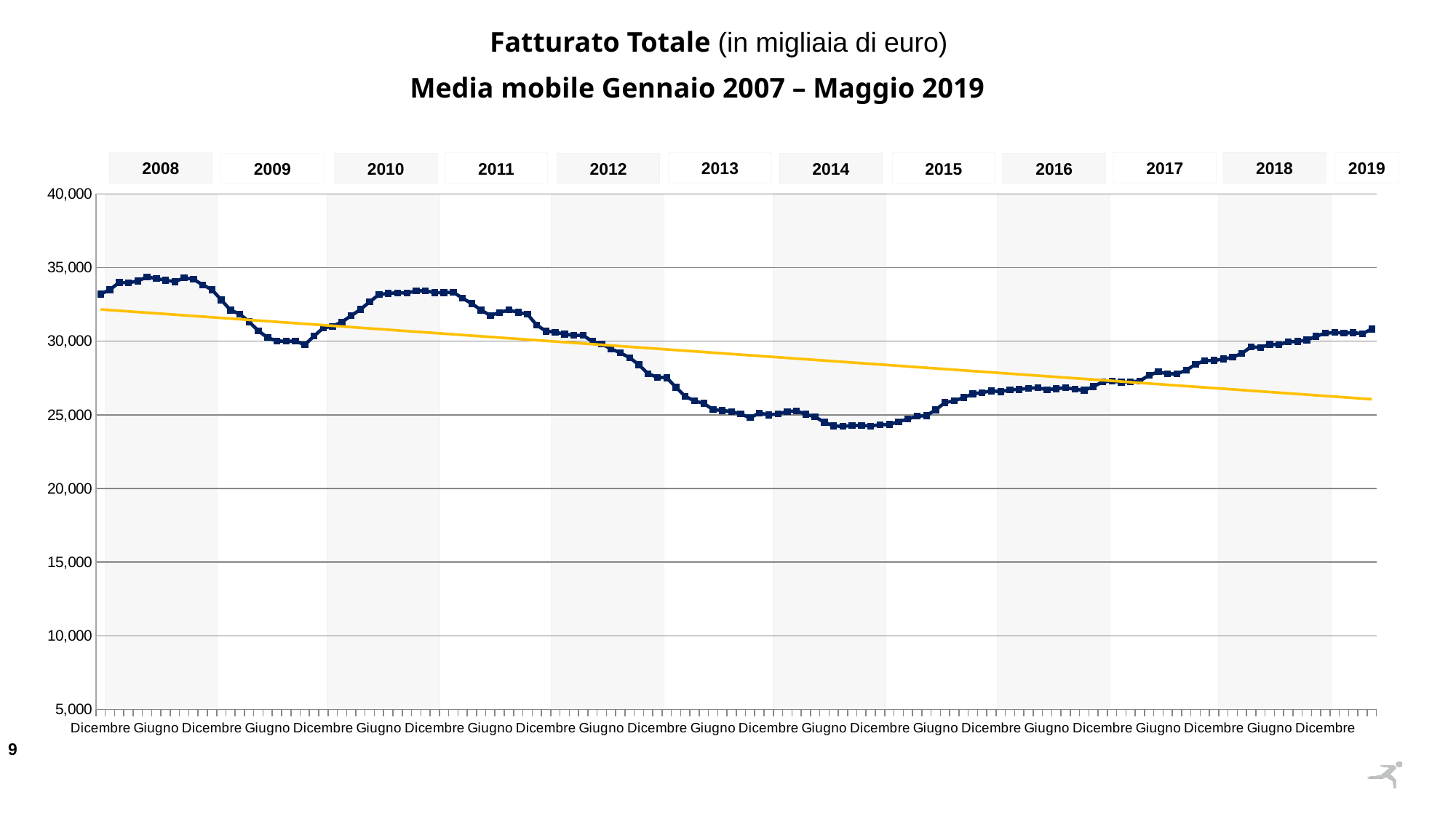
In which year does the moving average line reach its highest level? 2008 In which year does the moving average line reach its lowest level? 2014 Is the value of the moving average at its lowest point in 2014 greater or less than 25,000? less Is the value of the moving average in mid-2010 greater or less than 30,000? greater What kind of chart is shown on the slide? line chart Does the moving average line rise or fall between 2014 and 2019? rise Does the yellow trend line rise or fall from left to right? fall Which is higher, the moving average in 2008 or in 2014? 2008 What is the title of the chart? Fatturato Totale (in migliaia di euro) – Media mobile Gennaio 2007 – Maggio 2019 Is the value of the moving average during 2016 greater or less than 30,000? less How many year labels are shown across the top of the chart? 12